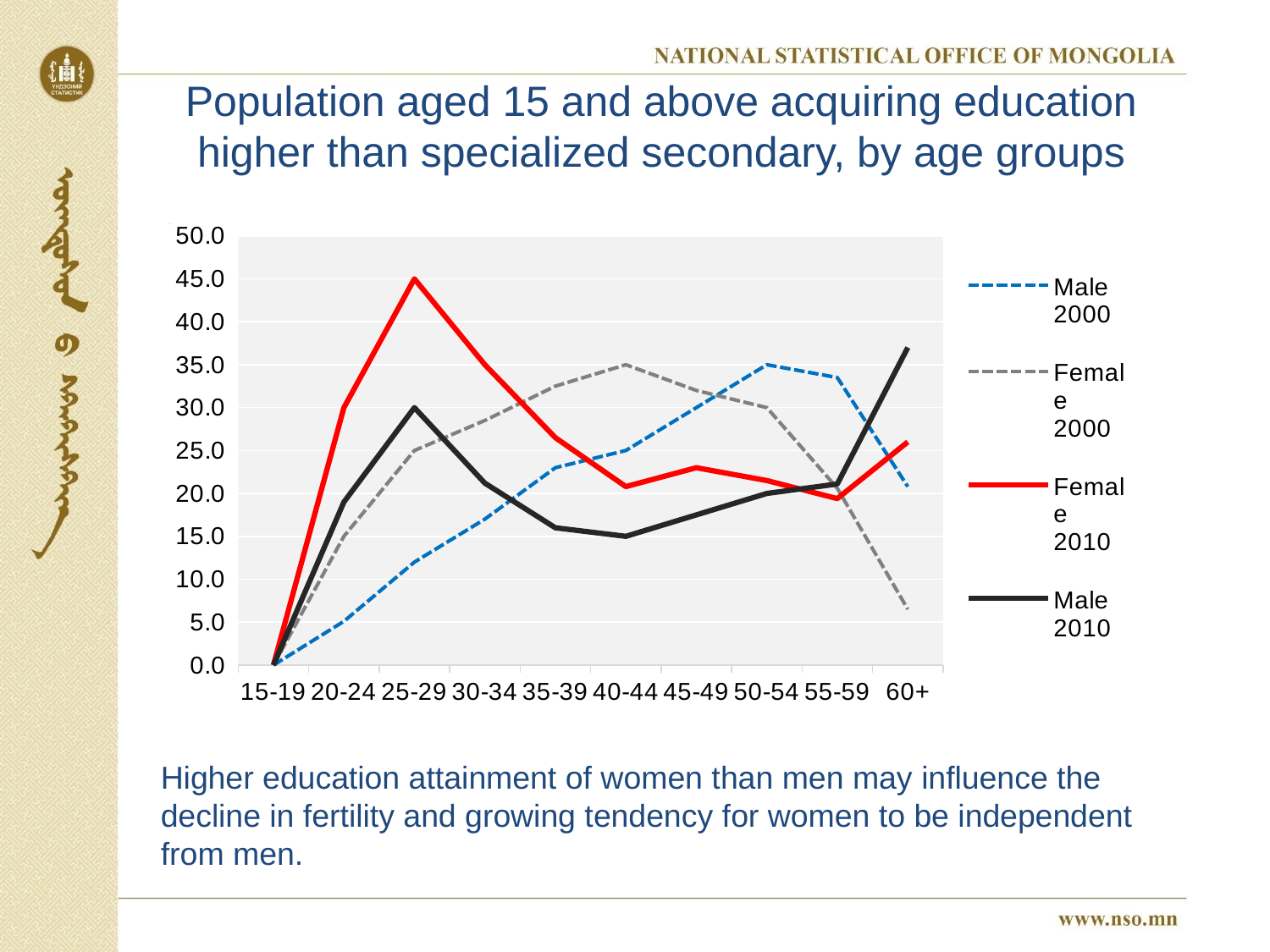
How many series does the legend list? 4 In the 25-29 age group, which is larger: Female 2010 or Male 2010? Female 2010 What colour is the Female 2010 line? red In the 60+ age group, which is larger: Male 2010 or Female 2010? Male 2010 Is the value for Female 2010 in the 25-29 age group greater or less than 40.0? greater In which age group does the Male 2000 line have its lowest value? 15-19 How many age groups are shown on the x axis? 10 Does the Male 2000 line rise or fall from the 15-19 age group to the 50-54 age group? rise In which age group does the Female 2010 line reach its highest value? 25-29 Is the value for Male 2000 in the 20-24 age group greater or less than 10.0? less What kind of chart is shown on the slide? line chart Is the value for Female 2000 in the 60+ age group greater or less than 10.0? less